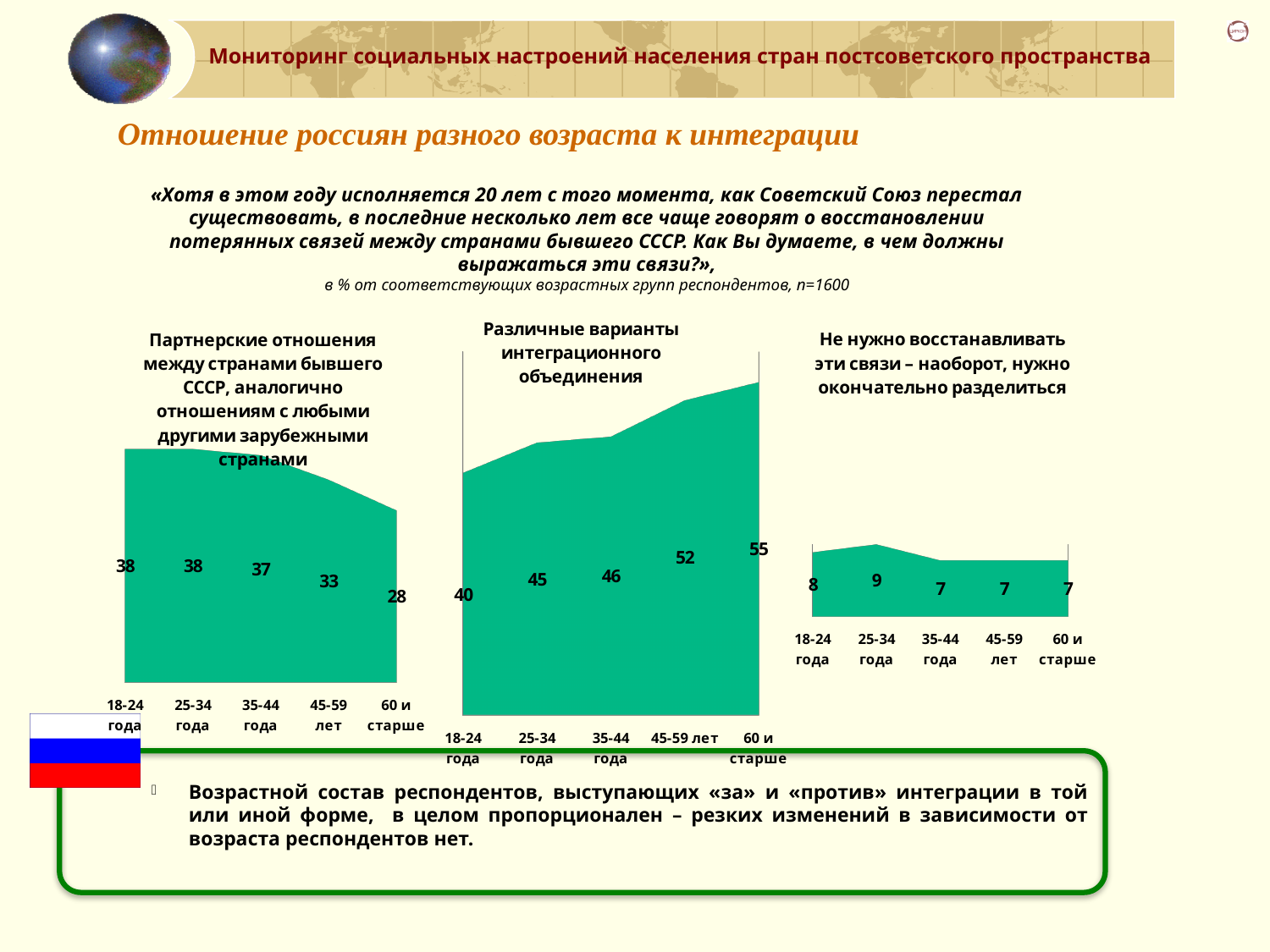
In the middle chart (Различные варианты интеграционного объединения), what is the difference between the values for 60 и старше and 18-24 года? 15 In the right chart (Не нужно восстанавливать эти связи), what is the value for the 25-34 года age group? 9 In the middle chart (Различные варианты интеграционного объединения), do the values rise or fall from the youngest to the oldest age group? Rise In the right chart (Не нужно восстанавливать эти связи), which is larger: the value for 25-34 года or the value for 35-44 года? 25-34 года What kind of chart is the left chart (Партнерские отношения между странами бывшего СССР)? Area chart How many age groups are shown on the x axis of the middle chart (Различные варианты интеграционного объединения)? 5 In the left chart (Партнерские отношения между странами бывшего СССР), what is the value for the 60 и старше age group? 28 In the left chart (Партнерские отношения между странами бывшего СССР), what is the difference between the values for 18-24 года and 45-59 лет? 5 In the left chart (Партнерские отношения между странами бывшего СССР), do the values rise or fall from the youngest to the oldest age group? Fall In the middle chart (Различные варианты интеграционного объединения), what is the value for the 45-59 лет age group? 52 In the left chart (Партнерские отношения между странами бывшего СССР), which age group has the lowest value? 60 и старше In the middle chart (Различные варианты интеграционного объединения), which age group has the highest value? 60 и старше